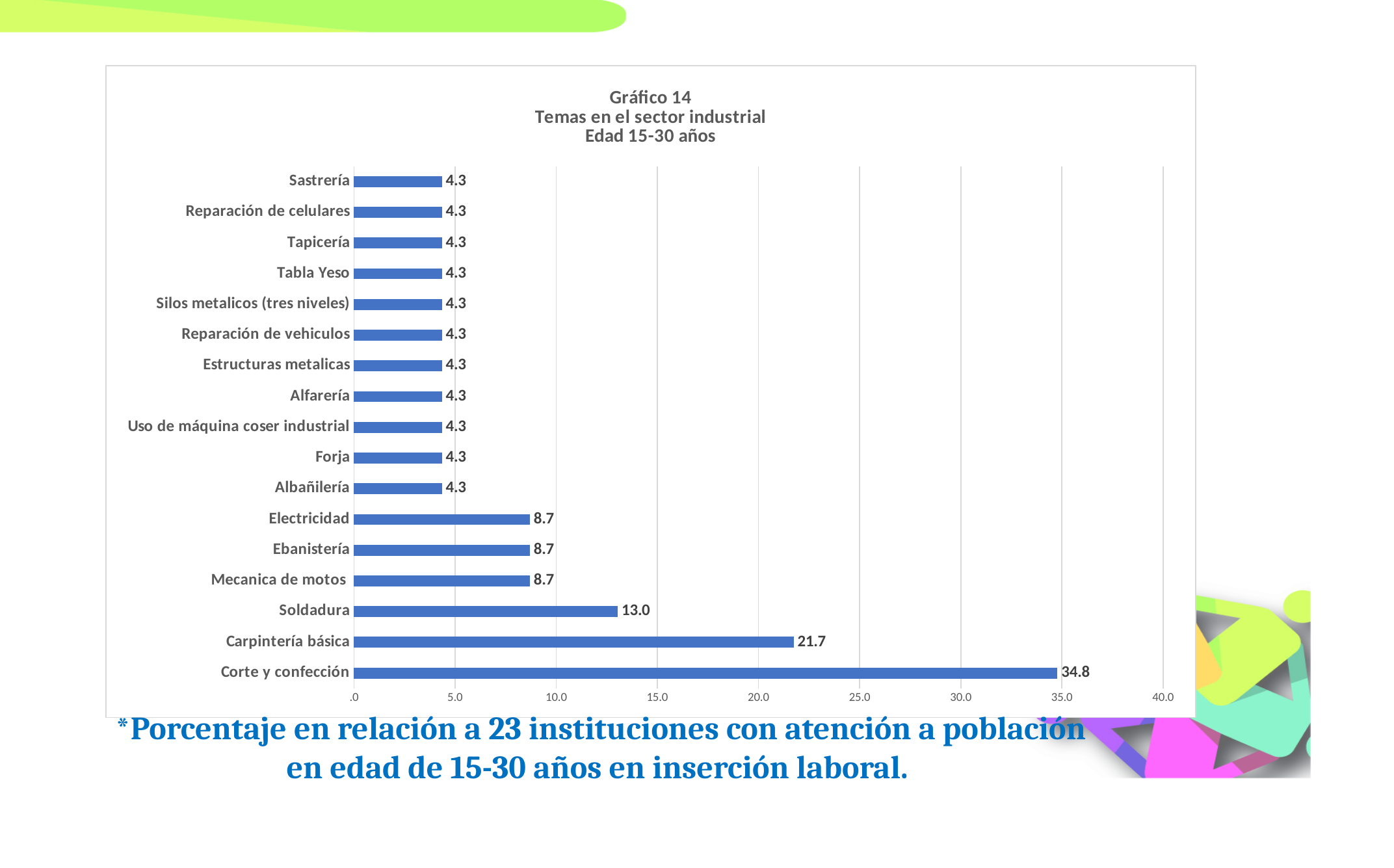
Which category has the highest value? Corte y confección Which is larger, the value for Soldadura or the value for Mecanica de motos? Soldadura What kind of chart is shown on the slide? Bar chart What is the value for Soldadura? 13.0 What is the value for Electricidad? 8.7 What is the value for Corte y confección? 34.8 Is the value for Carpintería básica greater or less than 20.0? greater What is the value for Tapicería? 4.3 What is the value for Carpintería básica? 21.7 What is the difference between the values for Soldadura and Ebanistería? 4.3 What is the difference between the values for Corte y confección and Carpintería básica? 13.1 How many categories are shown in the chart? 17